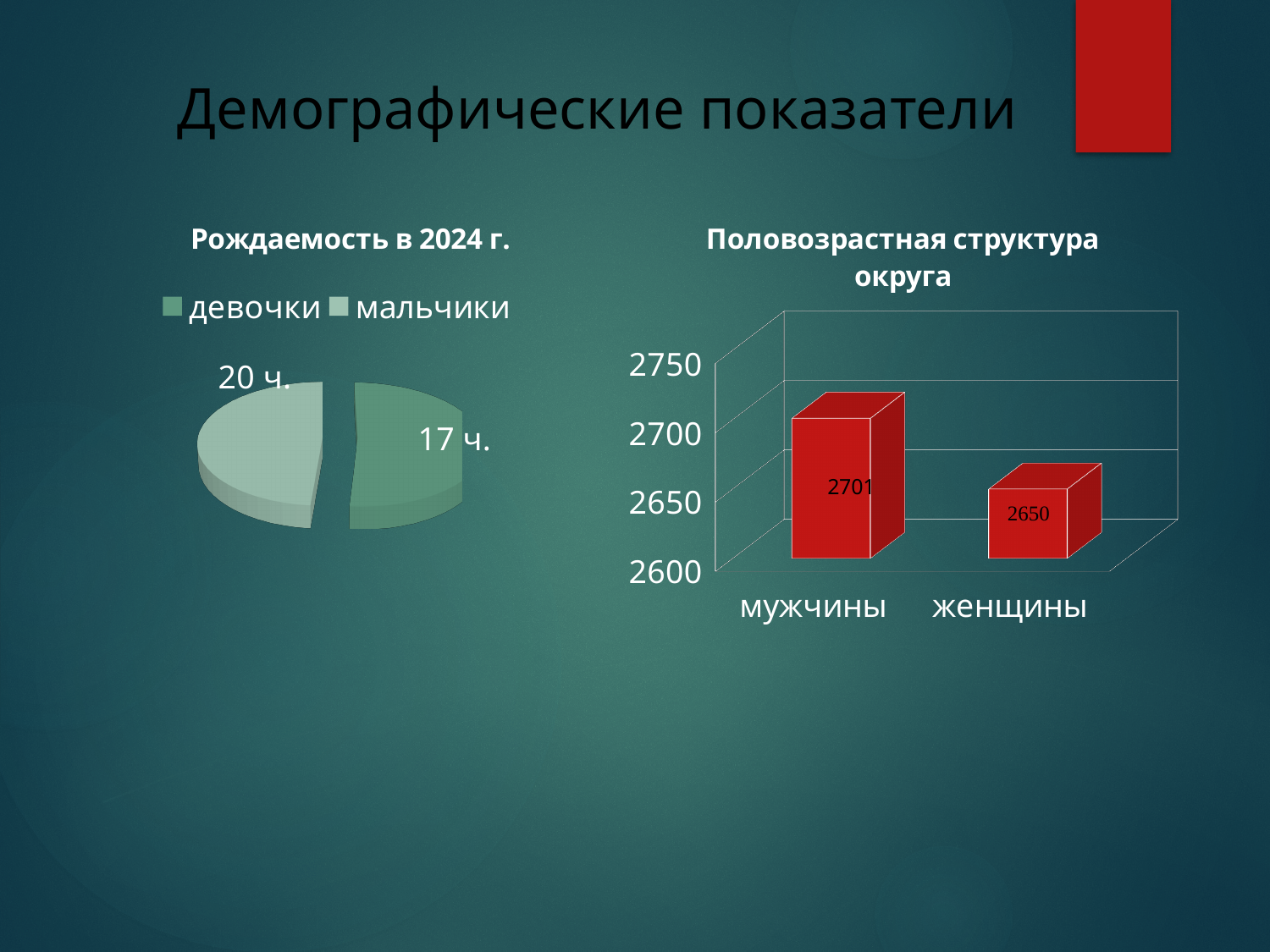
In the chart titled "Рождаемость в 2024 г.", which is larger, девочки or мальчики? мальчики In the chart titled "Рождаемость в 2024 г.", what is the value for мальчики? 20 ч. In the chart titled "Половозрастная структура округа", what is the value for женщины? 2650 What kind of chart is the one titled "Половозрастная структура округа"? bar chart In the chart titled "Половозрастная структура округа", which category has the lowest value? женщины In the chart titled "Рождаемость в 2024 г.", what is the value for девочки? 17 ч. In the chart titled "Половозрастная структура округа", what is the difference between the values for мужчины and женщины? 51 In the chart titled "Половозрастная структура округа", which category has the highest value? мужчины How many entries does the legend of the chart titled "Рождаемость в 2024 г." list? 2 In the chart titled "Половозрастная структура округа", what is the value for мужчины? 2701 What kind of chart is the one titled "Рождаемость в 2024 г."? pie chart In the chart titled "Половозрастная структура округа", how many categories are shown on the x axis? 2